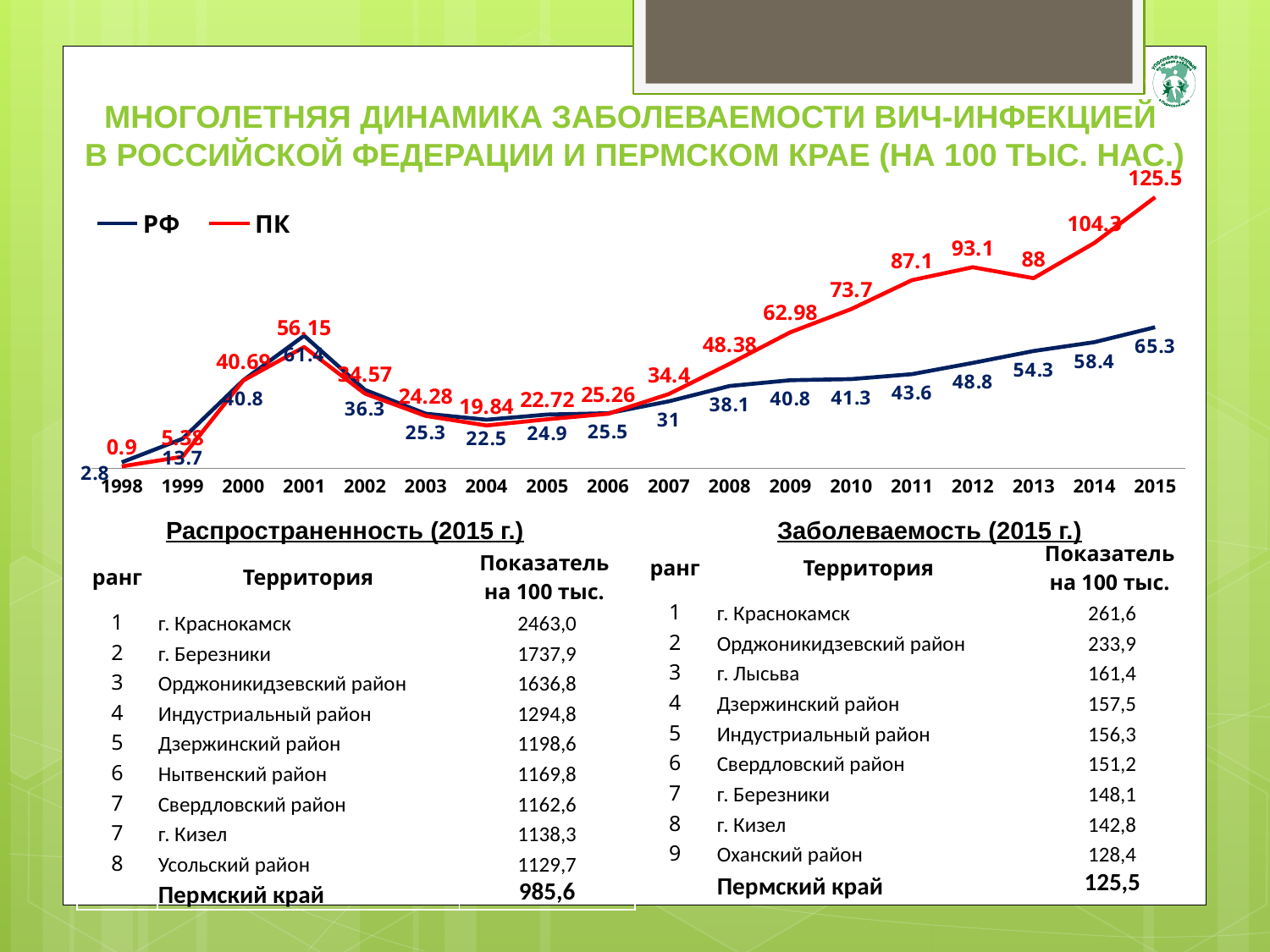
What is the value for ПК in 2015? 125.5 Does the ПК series rise or fall from 2007 to 2012? rise What is the value for РФ in 2004? 22.5 What is the value for ПК in 2012? 93.1 What is the difference between the ПК and РФ values in 2015? 60.2 What type of chart is shown on the slide? line chart In 2013, which series has the larger value, ПК or РФ? ПК In which year does the ПК series have its lowest value? 1998 How many series does the chart legend list? 2 In which year does the ПК series reach its highest value? 2015 What is the value for РФ in 2015? 65.3 How many years are shown on the x axis of the chart? 18